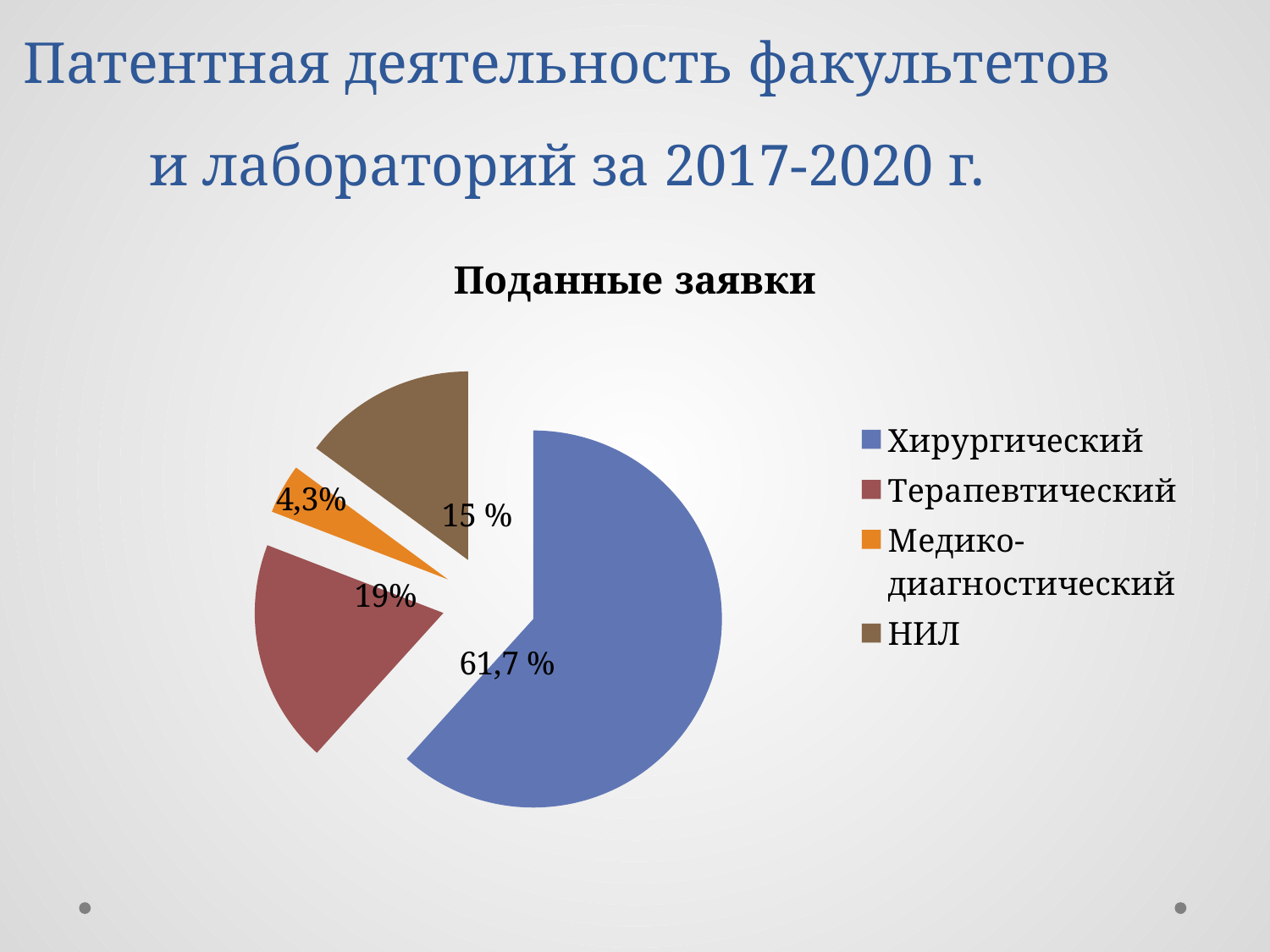
How many entries does the legend list? 4 What is the difference in percentage points between the Терапевтический slice and the НИЛ slice? 4 What share of the pie does Медико-диагностический have? 4,3% Which category has the smallest slice of the pie? Медико-диагностический How many slices does the pie chart have? 4 Which category has the largest slice of the pie? Хирургический What kind of chart is shown on the slide? pie chart Which is larger, the slice for Терапевтический or the slice for НИЛ? Терапевтический What share of the pie does НИЛ have? 15 % What share of the pie does Хирургический have? 61,7 % What is the title of the chart? Поданные заявки